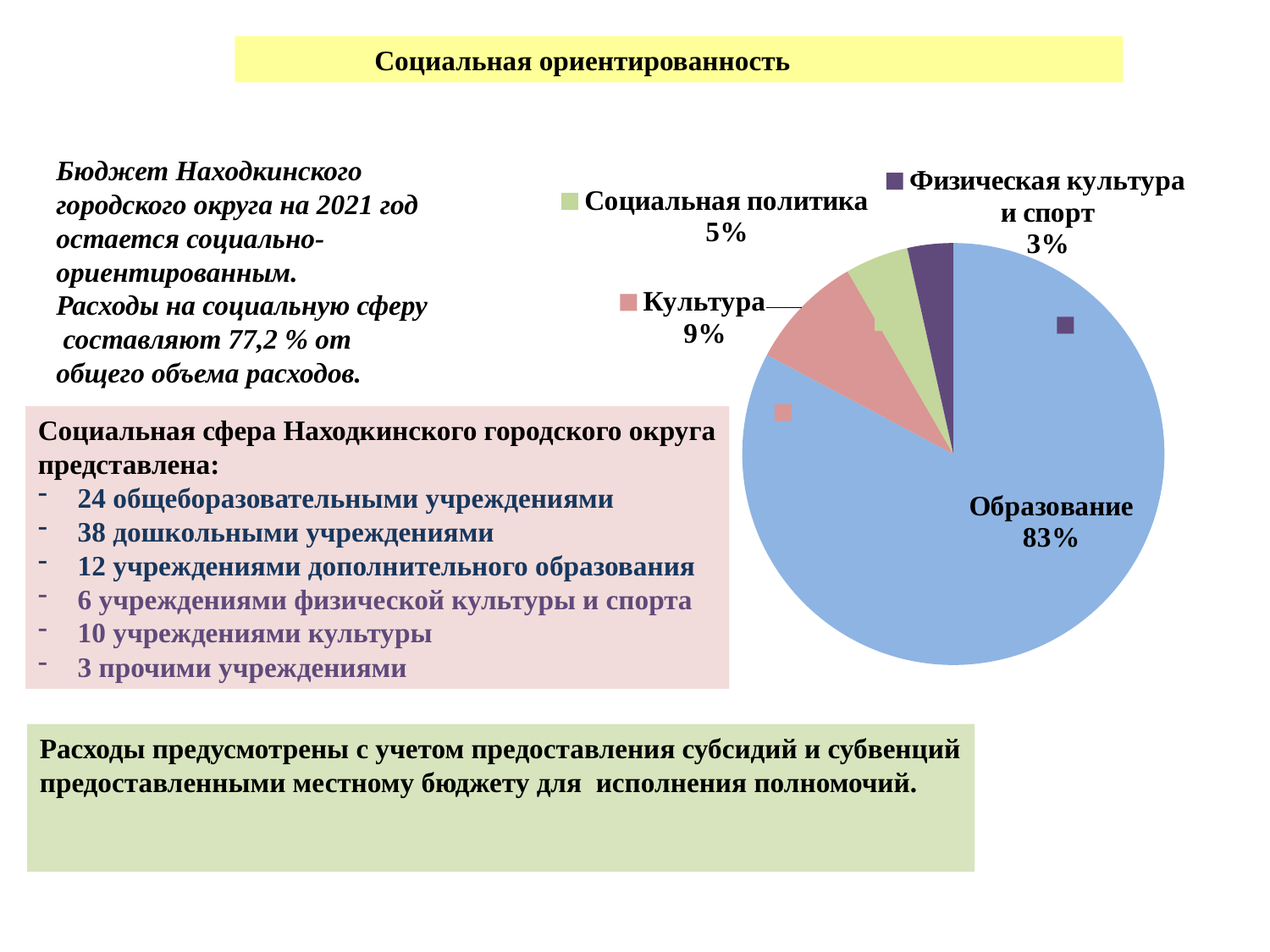
Which slice of the pie is the largest? Образование What share of the pie does Социальная политика have? 5% What kind of chart is shown on the slide? pie chart How many slices does the pie chart have? 4 What share of the pie does Физическая культура и спорт have? 3% Which slice of the pie is the smallest? Физическая культура и спорт Which is larger, the share for Культура or the share for Социальная политика? Культура What is the combined share of Культура and Социальная политика? 14% What colour is the Образование slice of the pie? blue What share of the pie does Образование have? 83% What is the difference in percentage points between Образование and Культура? 74 What share of the pie does Культура have? 9%